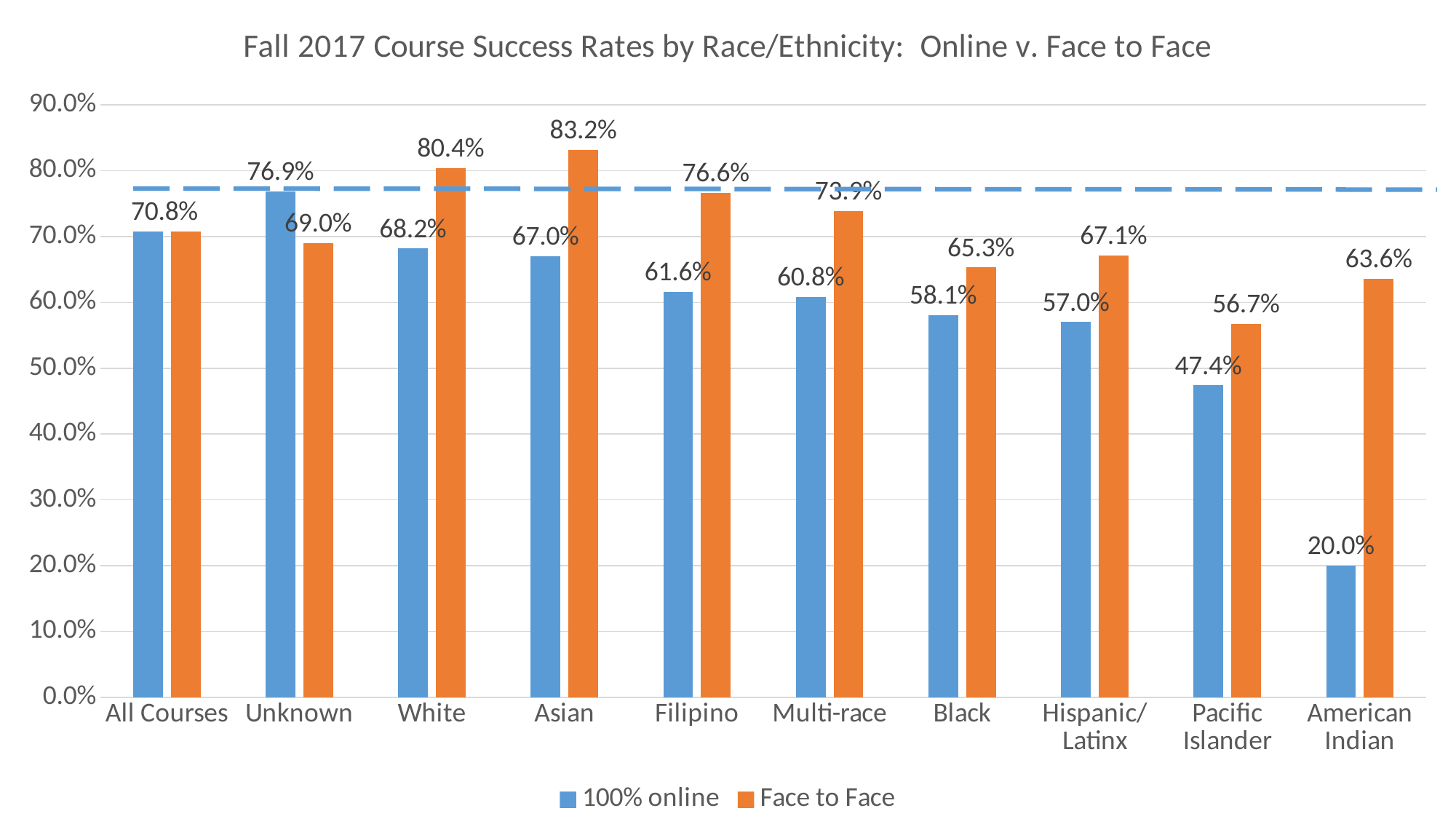
How many series does the legend list? 2 What is the 100% online success rate for Pacific Islander students? 47.4% What is the 100% online course success rate for American Indian students? 20.0% For Unknown, which is larger: the 100% online rate or the Face to Face rate? 100% online Which category has the lowest 100% online success rate? American Indian Which colour represents the Face to Face series? Orange How many race/ethnicity categories are shown on the x axis? 10 What kind of chart is shown on the slide? Bar chart Which race/ethnicity category has the highest Face to Face success rate? Asian Is the Face to Face success rate for Filipino students greater or less than 70.0%? greater What is the Face to Face course success rate for Asian students? 83.2% What is the difference between the Face to Face and 100% online success rates for White students? 12.2%